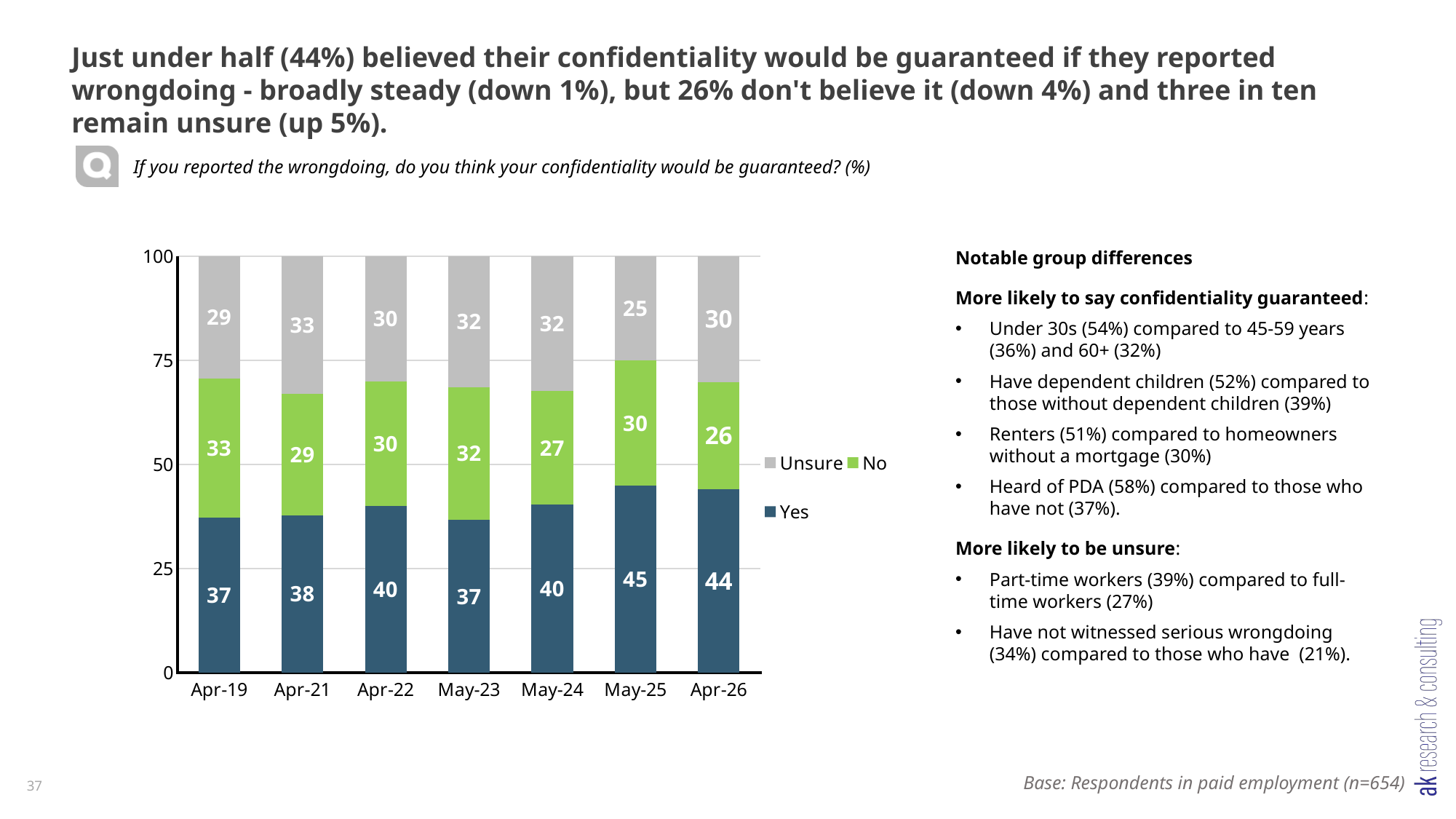
Which is larger, the 'No' value for May-23 or the 'No' value for Apr-26? May-23 Which series is shown in green? No What is the 'Unsure' value for May-25? 25 How many periods are shown on the x axis? 7 How many series does the legend list? 3 What kind of chart is shown? Stacked bar chart What is the 'No' value for Apr-19? 33 What is the total of the stacked bar for Apr-21? 100 Which period has the lowest 'Unsure' value? May-25 Which period has the highest 'Yes' value? May-25 What is the difference between the 'Yes' values for May-25 and Apr-19? 8 What is the 'Yes' value for Apr-26? 44